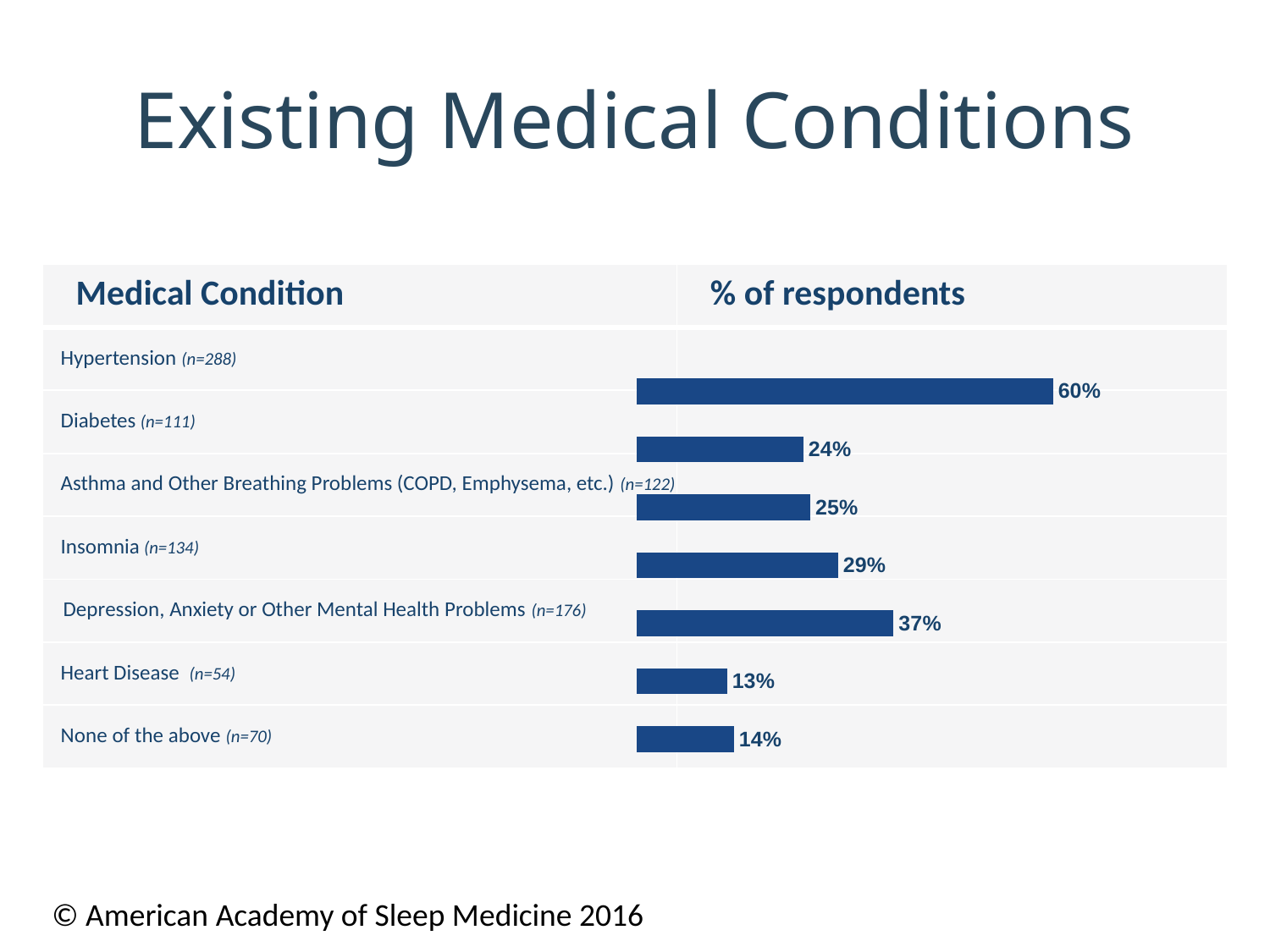
Which medical condition has the highest percentage of respondents? Hypertension What is the difference in percentage points between Hypertension and Diabetes? 36 What is the difference in percentage points between Depression, Anxiety or Other Mental Health Problems and Insomnia? 8 How many medical condition categories are shown in the chart? 7 What percentage of respondents reported Hypertension? 60% What percentage of respondents reported Depression, Anxiety or Other Mental Health Problems? 37% What is the title of the slide? Existing Medical Conditions Which medical condition has the lowest percentage of respondents? Heart Disease What percentage of respondents reported Heart Disease? 13% Which has a higher percentage of respondents, Insomnia or Asthma and Other Breathing Problems? Insomnia What type of chart is shown on the slide? Bar chart What percentage of respondents reported Insomnia? 29%